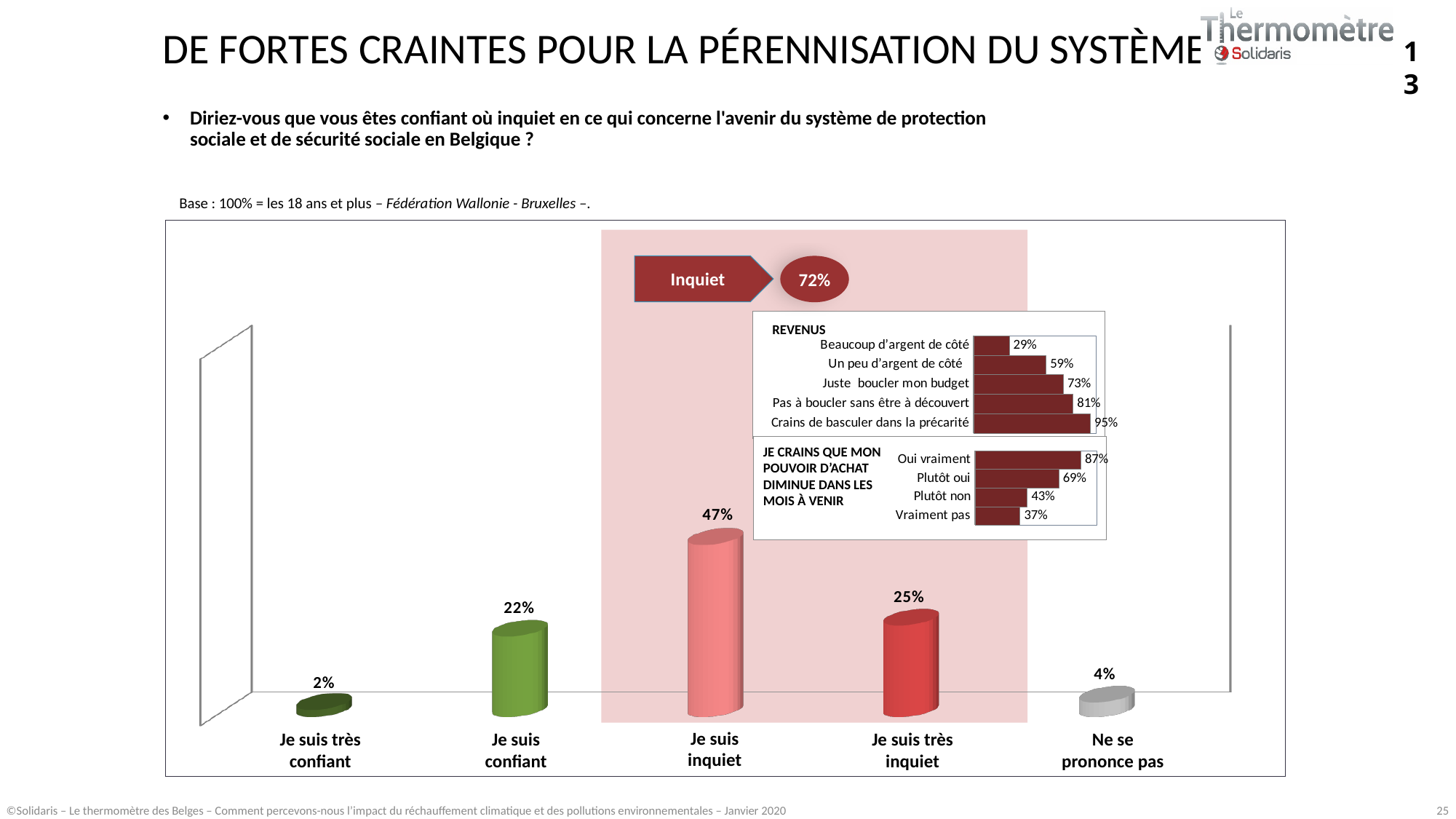
In the main chart, which category has the lowest value? Je suis très confiant In the REVENUS chart, do the values rise or fall going down the list from "Beaucoup d'argent de côté" to "Crains de basculer dans la précarité"? rise In the REVENUS chart, what is the value for "Crains de basculer dans la précarité"? 95% What kind of chart is the main chart? bar chart In the main chart, how many categories are shown? 5 In the "Je crains que mon pouvoir d'achat diminue dans les mois à venir" chart, which is larger, "Oui vraiment" or "Vraiment pas"? Oui vraiment In the main chart, which category has the highest value? Je suis inquiet In the "Je crains que mon pouvoir d'achat diminue dans les mois à venir" chart, what is the value for "Plutôt oui"? 69% In the main chart, what is the value for "Je suis inquiet"? 47% In the main chart, what is the difference between "Je suis inquiet" and "Je suis très inquiet"? 22% In the REVENUS chart, which category has the lowest value? Beaucoup d'argent de côté In the main chart, what is the value for "Je suis très confiant"? 2%